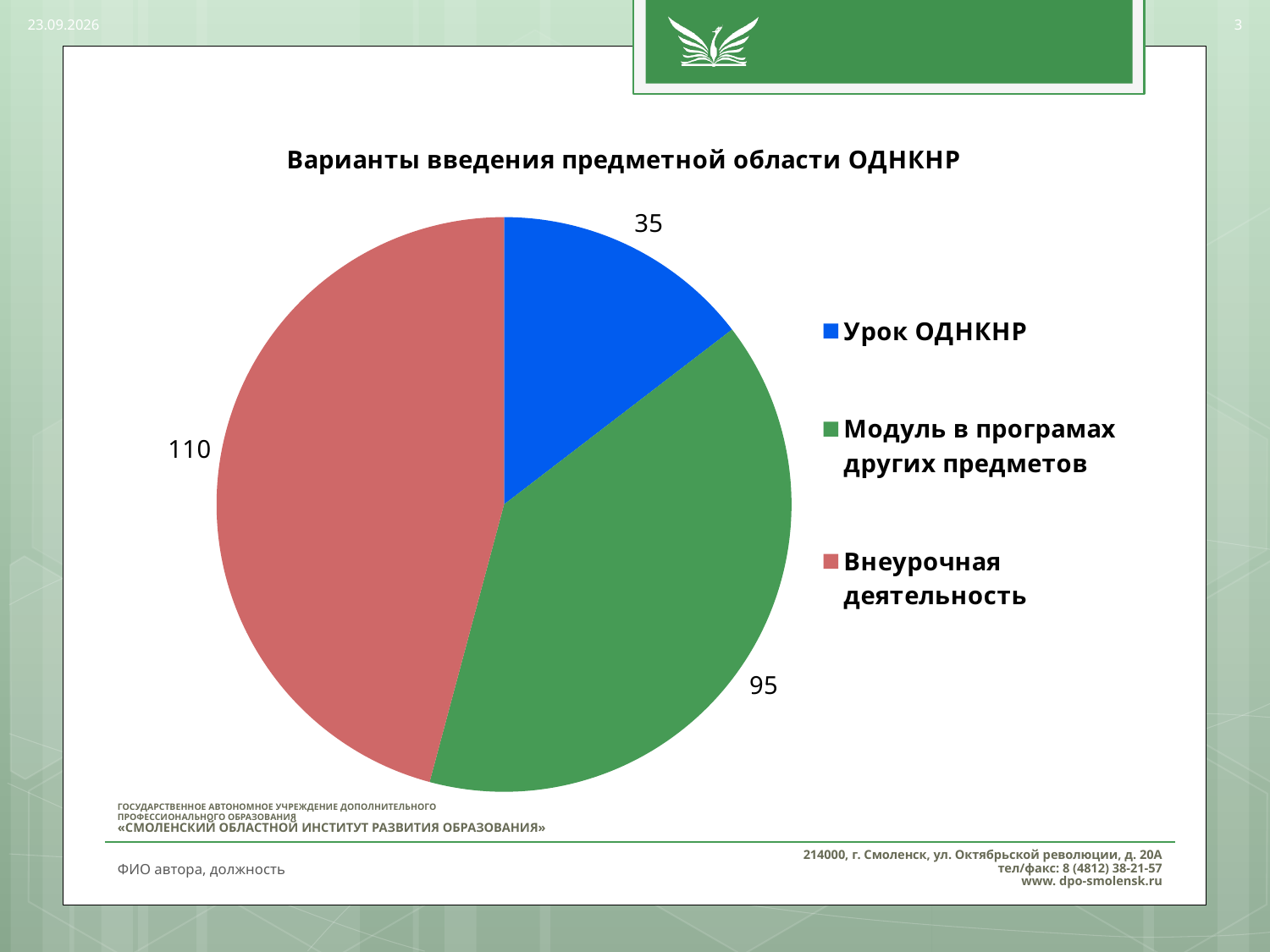
What is the difference between the values for Внеурочная деятельность and Модуль в програмах других предметов? 15 What is the title of the chart? Варианты введения предметной области ОДНКНР How many slices does the pie chart have? 3 Which is larger: the value for Модуль в програмах других предметов or the value for Урок ОДНКНР? Модуль в програмах других предметов Which category has the smallest slice? Урок ОДНКНР What is the value for Урок ОДНКНР? 35 What is the value for Внеурочная деятельность? 110 What type of chart is shown on the slide? Pie chart Which category has the largest slice? Внеурочная деятельность What colour is the slice for Урок ОДНКНР? Blue What is the difference between the values for Внеурочная деятельность and Урок ОДНКНР? 75 What is the value for Модуль в програмах других предметов? 95